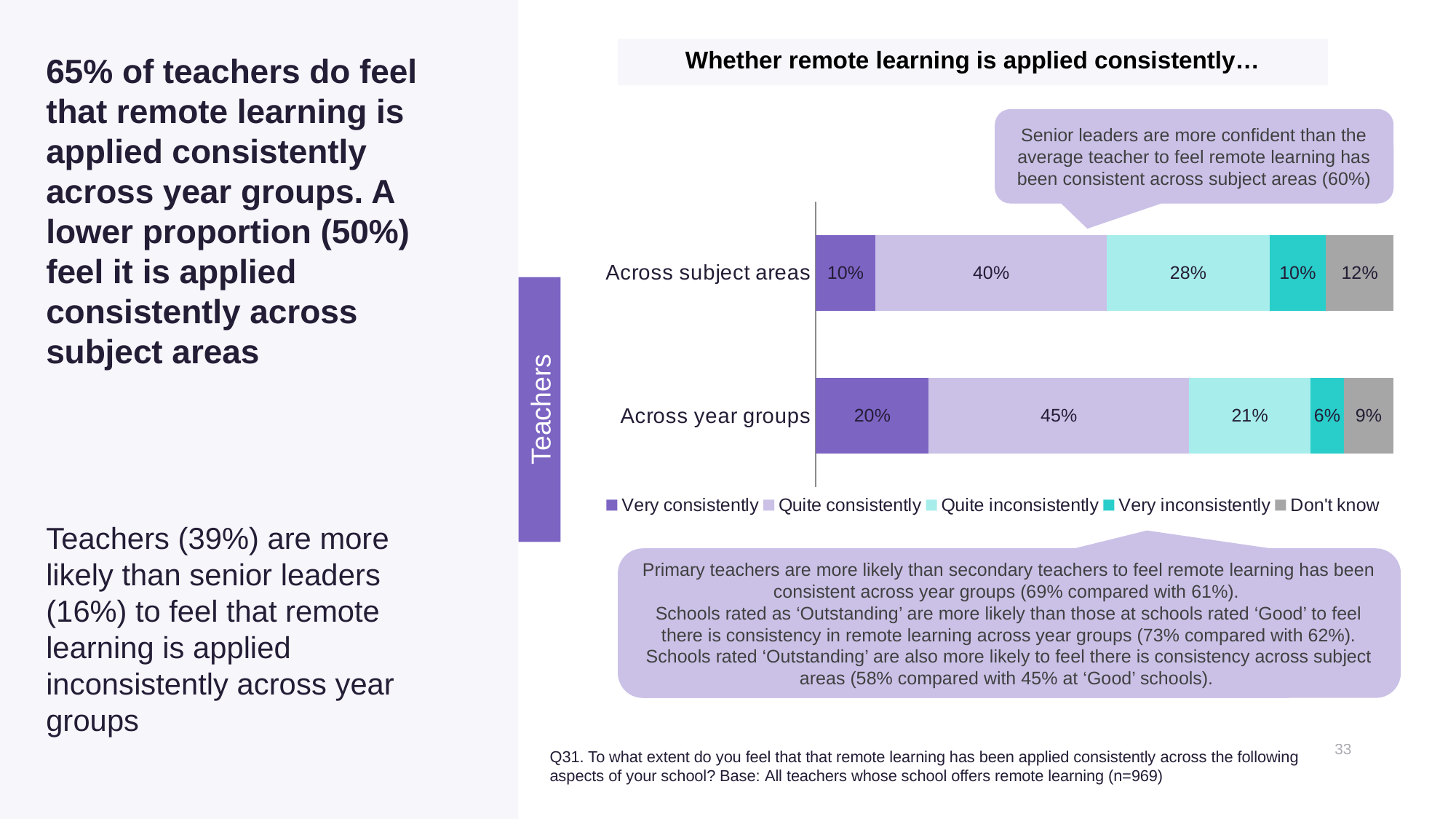
What percentage of teachers said remote learning is applied 'Very consistently' across year groups? 20% How many series does the legend list? 5 What is the difference between the 'Very consistently' values for 'Across year groups' and 'Across subject areas'? 10% How many categories are shown on the chart? 2 Which series has the smallest segment in the 'Across year groups' bar? Very inconsistently What is the 'Don't know' value for 'Across subject areas'? 12% Which category has the higher 'Quite inconsistently' value, 'Across subject areas' or 'Across year groups'? Across subject areas What percentage of teachers said remote learning is applied 'Quite consistently' across subject areas? 40% What is the combined 'Very consistently' and 'Quite consistently' share for 'Across year groups'? 65% What type of chart is shown on the slide? Stacked bar chart What is the 'Very inconsistently' value for 'Across year groups'? 6% Which series has the largest segment in the 'Across subject areas' bar? Quite consistently